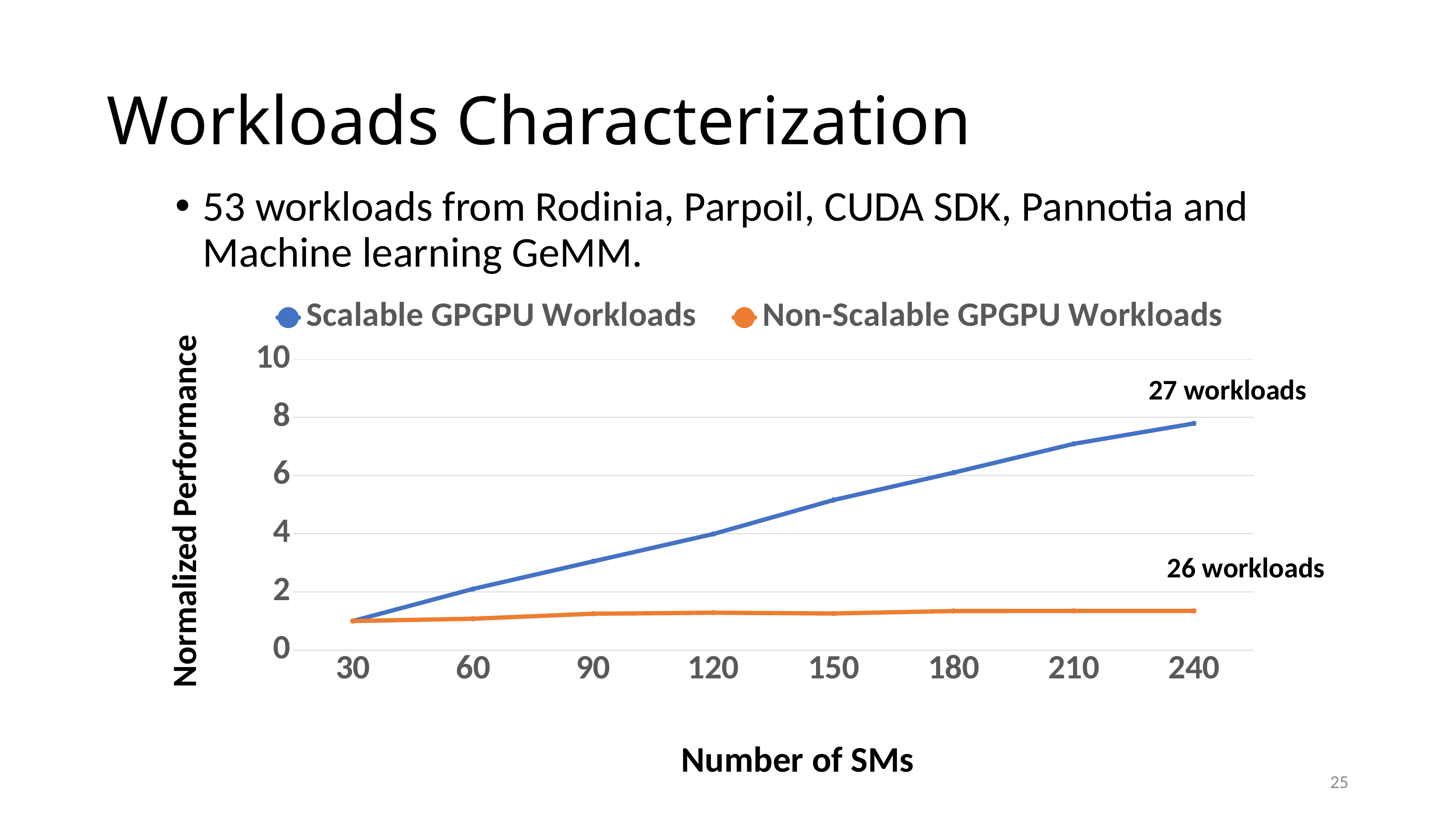
At 240 SMs, which series has the larger value, Scalable GPGPU Workloads or Non-Scalable GPGPU Workloads? Scalable GPGPU Workloads What is the title of the x axis? Number of SMs Is the value for Scalable GPGPU Workloads at 210 SMs greater or less than 6? greater What kind of chart is shown on the slide? line chart Is the value for Scalable GPGPU Workloads at 150 SMs greater or less than 4? greater At which Number of SMs does the Scalable GPGPU Workloads series reach its highest value? 240 How many Number of SMs points are plotted along the x axis? 8 Is the value for Scalable GPGPU Workloads at 240 SMs greater or less than 6? greater Do the values for Scalable GPGPU Workloads rise or fall as the Number of SMs increases? rise How many series does the legend list? 2 How many workloads does the annotation next to the Scalable GPGPU Workloads line say it represents? 27 workloads